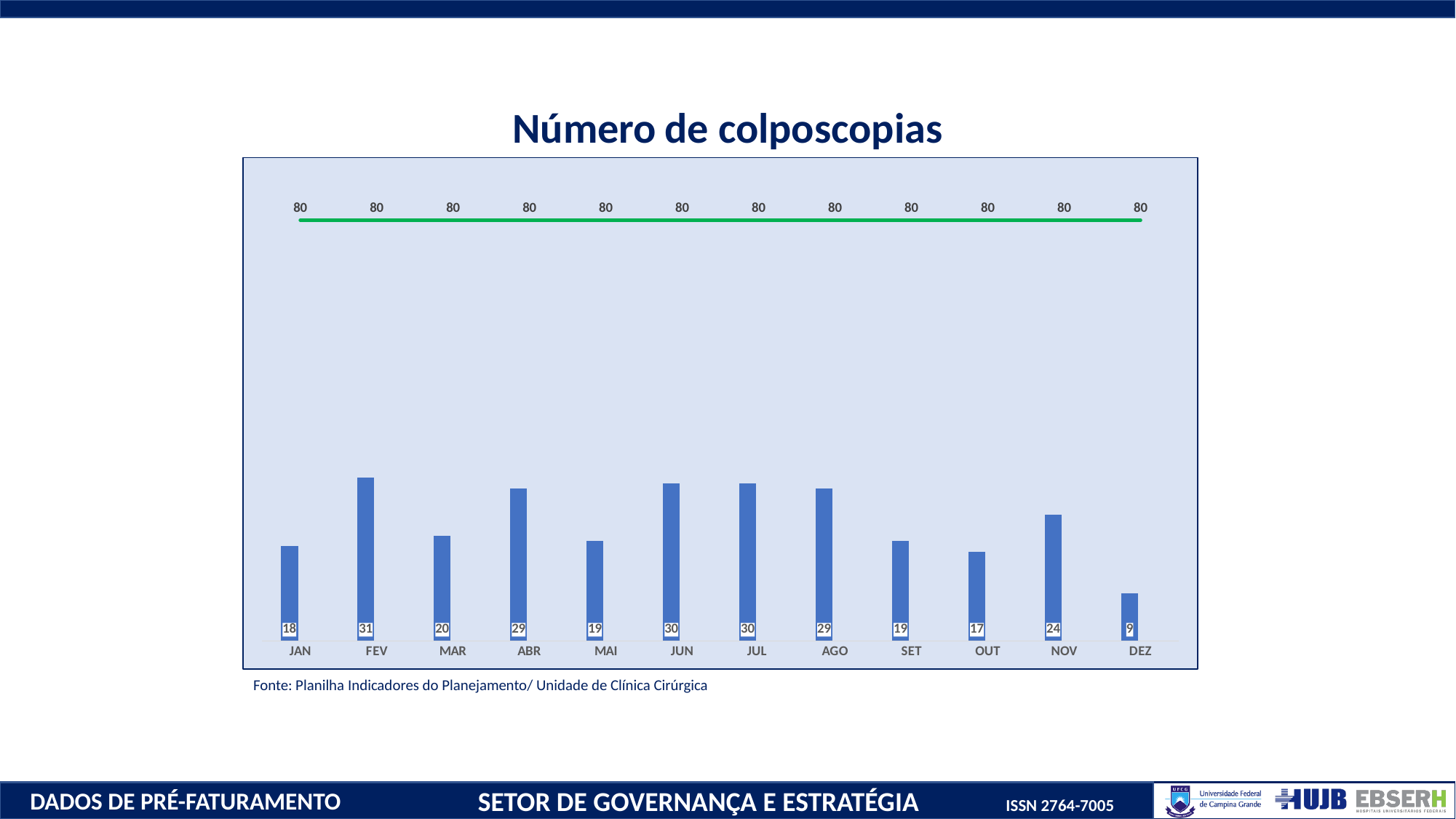
What is the number of colposcopias for DEZ? 9 What value does the green line show for every month? 80 Which month has more colposcopias, NOV or OUT? NOV What is the difference between the number of colposcopias in FEV and DEZ? 22 What is the difference between the number of colposcopias in ABR and MAI? 10 Which month has the highest number of colposcopias? FEV Which month has the lowest number of colposcopias? DEZ What is the title of the chart? Número de colposcopias How many months are shown on the x axis of the chart? 12 What is the number of colposcopias for NOV? 24 What is the number of colposcopias for FEV? 31 What kind of chart is used to show the number of colposcopias? Bar chart